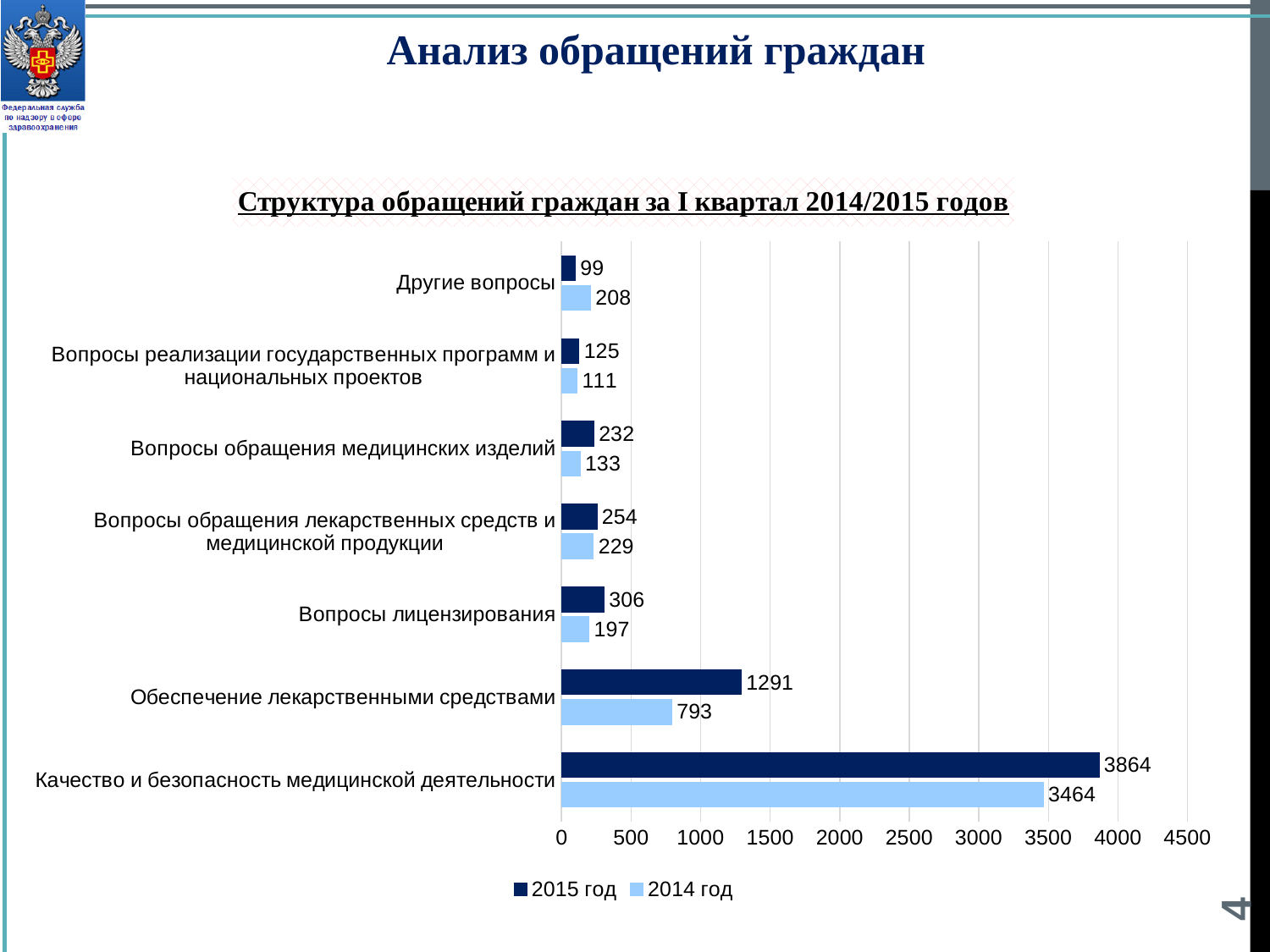
What is the value for 2015 год for Вопросы лицензирования? 306 What is the difference between the 2015 год and 2014 год values for Обеспечение лекарственными средствами? 498 What kind of chart is shown on the slide? Bar chart What is the value for 2015 год for Качество и безопасность медицинской деятельности? 3864 Which is larger for Вопросы обращения медицинских изделий: the 2015 год value or the 2014 год value? 2015 год Which category has the highest value for 2015 год? Качество и безопасность медицинской деятельности What is the title of the chart? Структура обращений граждан за I квартал 2014/2015 годов What is the value for 2014 год for Другие вопросы? 208 How many categories are shown on the chart? 7 What is the value for 2014 год for Обеспечение лекарственными средствами? 793 Which category has the lowest value for 2015 год? Другие вопросы How many series does the legend list? 2